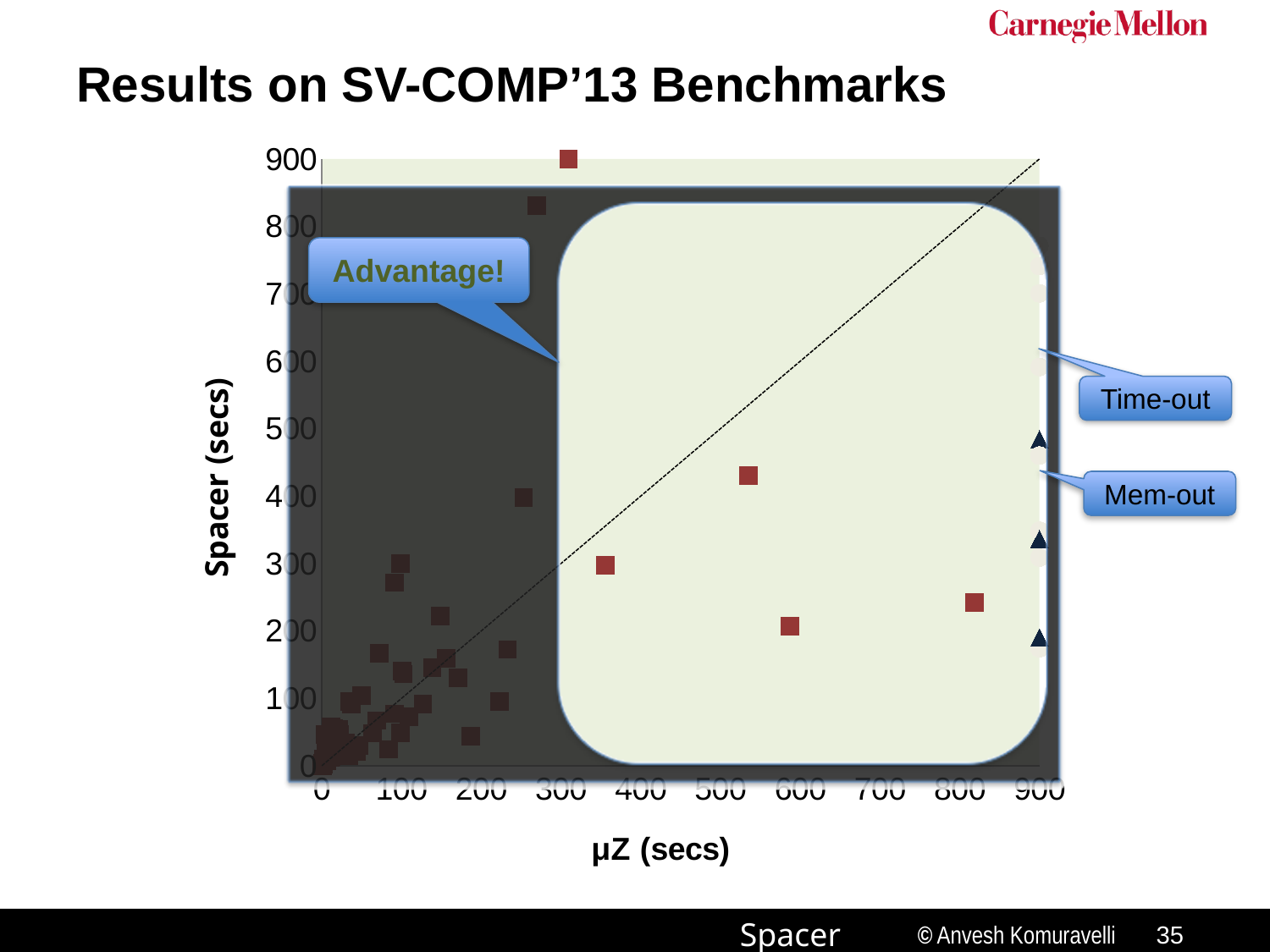
Are the triangle markers plotted at the high end or the low end of the μZ (secs) axis? high end For the square point plotted at roughly 540 on the μZ axis, is its Spacer (secs) value larger or smaller than its μZ (secs) value? smaller Is the highest Spacer (secs) value plotted on the chart greater or less than 800? greater For the square point plotted at roughly 590 on the μZ axis, is its Spacer (secs) value greater or less than 300? less What is the label of the y axis of the chart? Spacer (secs) For the square point plotted at roughly 540 on the μZ axis, is its Spacer (secs) value greater or less than 500? less What kind of chart is shown on the slide? scatter plot How many triangle markers are plotted on the chart? 3 What is the label of the x axis of the chart? μZ (secs)